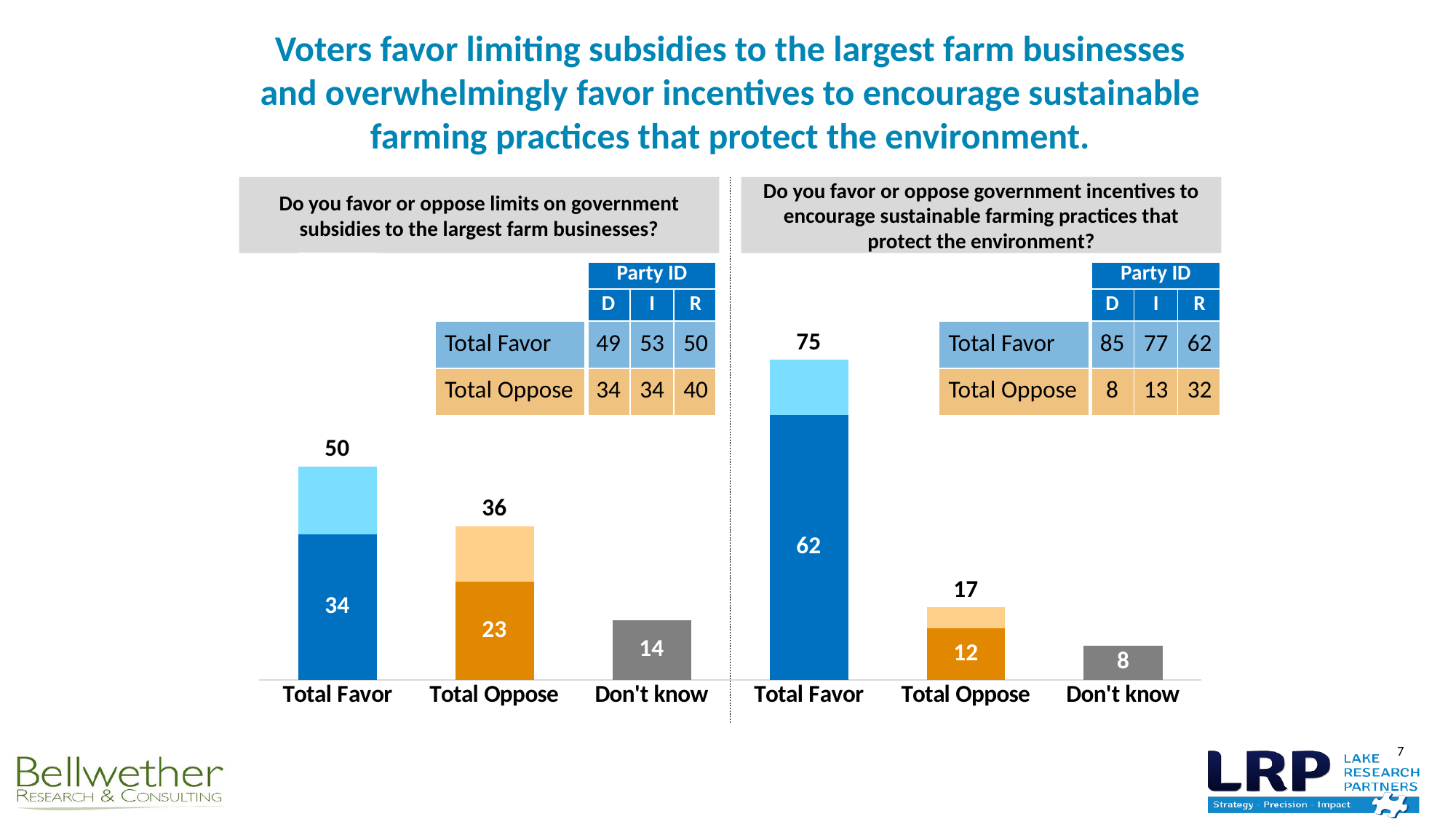
Is the Total Favor total larger in the left chart on subsidy limits or in the right chart on sustainable farming incentives? Right chart (sustainable farming incentives) In the right chart on government incentives for sustainable farming practices, what is the total value for Total Favor? 75 In the right chart on government incentives for sustainable farming practices, which category has the lowest value? Don't know In the right chart on government incentives for sustainable farming practices, what is the difference between the Total Favor total and the Total Oppose total? 58 In the left chart on limits on government subsidies, what is the value for Don't know? 14 In the left chart on limits on government subsidies, what is the value of the dark blue (strongly favor) segment of the Total Favor bar? 34 How many categories are shown on the x axis of the right chart on government incentives for sustainable farming practices? 3 In the left chart on limits on government subsidies to the largest farm businesses, what is the total value for Total Favor? 50 In the left chart on limits on government subsidies, what is the difference between the Total Favor total and the Total Oppose total? 14 What type of chart is used in the left chart on limits on government subsidies? Stacked bar chart In the right chart on government incentives for sustainable farming practices, what is the value of the dark orange (strongly oppose) segment of the Total Oppose bar? 12 In the left chart on limits on government subsidies, which category has the highest total value? Total Favor